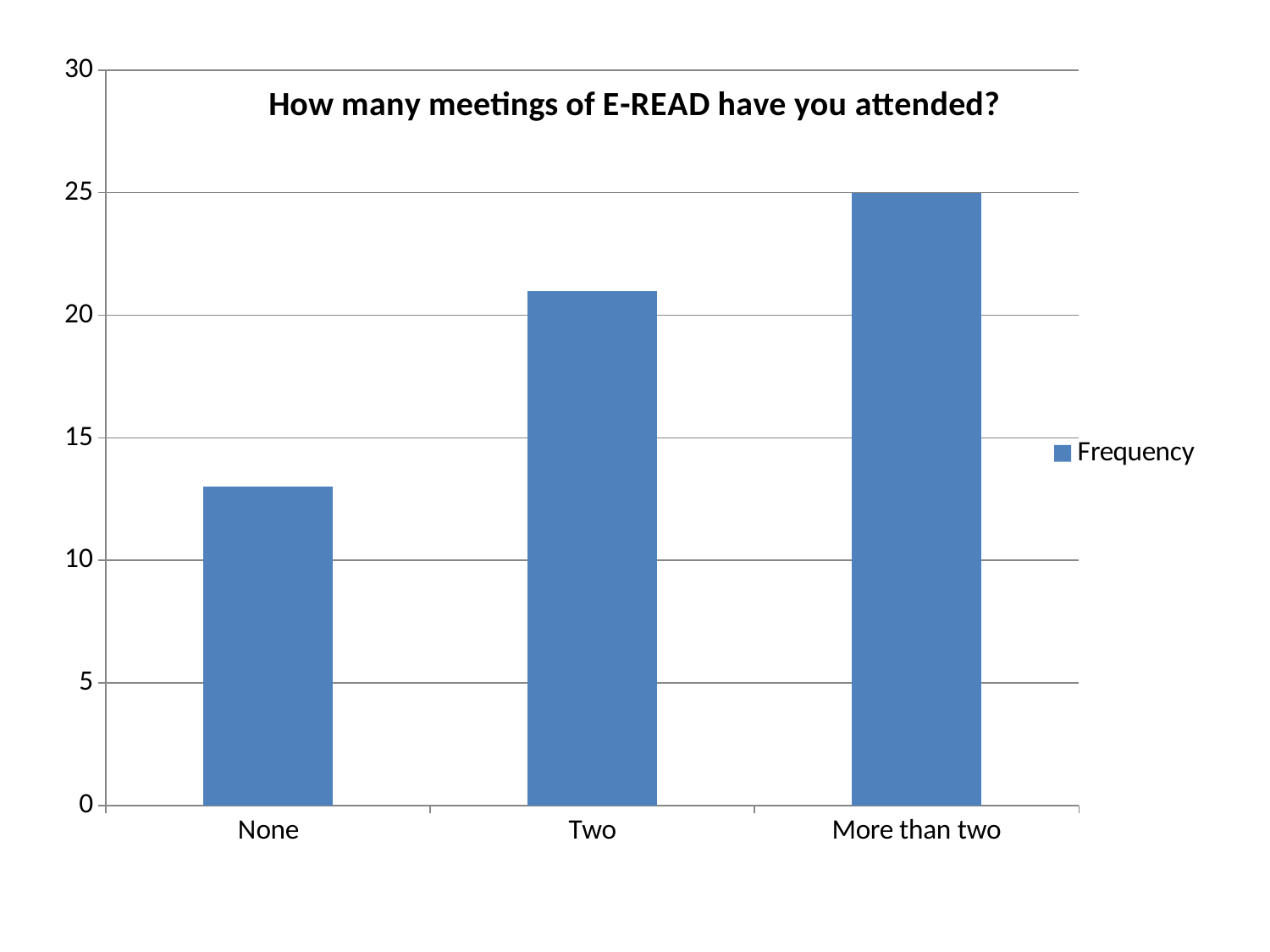
How many categories are shown on the x axis? 3 Do the frequencies rise or fall from 'None' to 'More than two'? rise Which is larger, the frequency for 'None' or for 'Two'? Two Which category has the highest frequency? More than two Which category has the lowest frequency? None What kind of chart is shown on the slide? bar chart What is the title of the chart? How many meetings of E-READ have you attended? How many series does the legend list? 1 What is the frequency for 'More than two'? 25 Is the frequency for 'Two' greater or less than 20? greater Is the frequency for 'None' greater or less than 15? less What series name is shown in the legend? Frequency